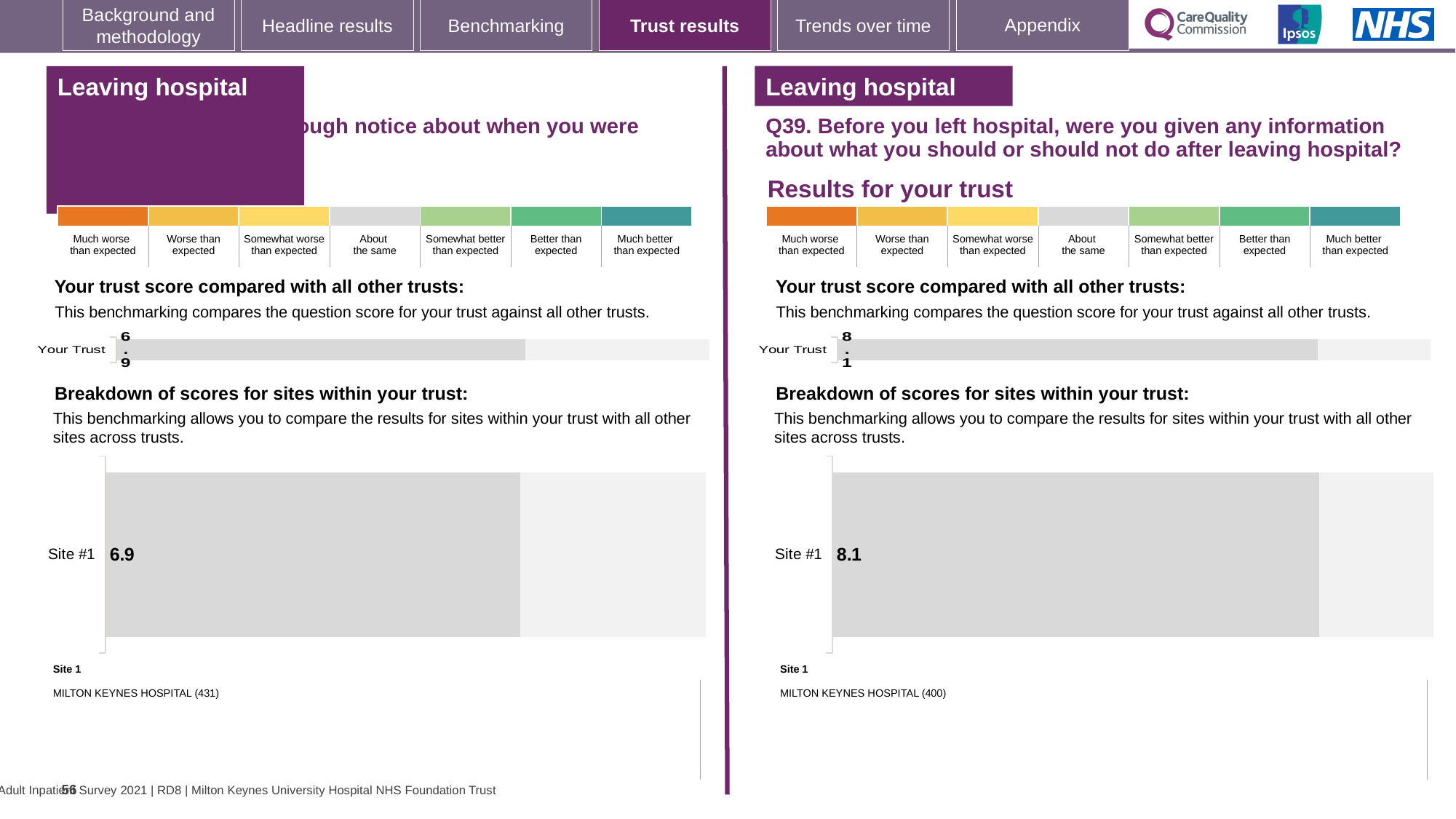
In the left-hand 'Breakdown of scores for sites within your trust' chart, what is the value for Site #1? 6.9 How many sites are plotted in the left-hand 'Breakdown of scores for sites within your trust' chart? 1 Which is larger: the Site #1 score in the left-hand breakdown chart or the Site #1 score in the right-hand breakdown chart? the right-hand chart (8.1) In the right-hand 'Breakdown of scores for sites within your trust' chart, what is the value for Site #1? 8.1 According to the site key on the right-hand side, which hospital is Site 1 and how many respondents are shown in brackets? MILTON KEYNES HOSPITAL (400) What is the difference between the Site #1 score on the right-hand side (8.1) and the Site #1 score on the left-hand side (6.9)? 1.2 What type of chart is used to show the Site #1 score on the right-hand side of the slide? bar chart On the left-hand side of the slide, what is the score shown for Your Trust? 6.9 On the right-hand side of the slide (Q39), what is the score shown for Your Trust? 8.1 How many sites are plotted in the right-hand 'Breakdown of scores for sites within your trust' chart? 1 What type of chart is used to show the Your Trust score on the left-hand side of the slide? bar chart Which question number is shown in the title of the right-hand side of the slide? Q39